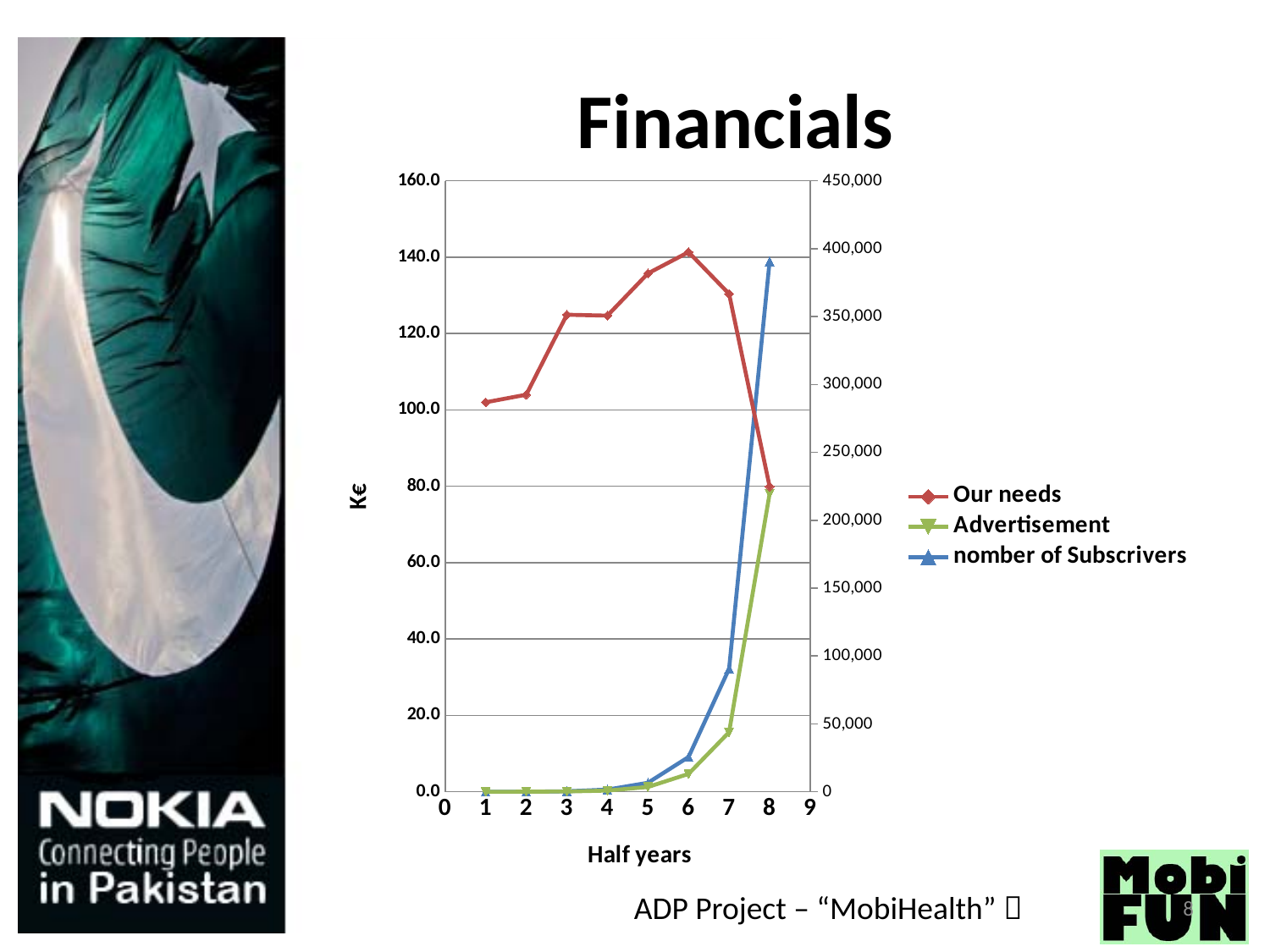
Is the value of Our needs at half year 1 greater or less than 120.0 K€? less How many series does the legend of the Financials chart list? 3 Is the value of Our needs at half year 6 greater or less than 120.0 K€? greater Which is larger for the Our needs series: the value at half year 2 or at half year 6? half year 6 What kind of chart is shown on the Financials slide? line chart Does the Advertisement series rise or fall from half year 1 to half year 8? rise Is the number of Subscrivers at half year 8 greater or less than 350,000? greater At which half year is the Our needs series at its lowest value? 8 What is the label of the left vertical axis of the Financials chart? K€ How many half-year data points are plotted for the Our needs series? 8 At which half year does the Our needs series reach its highest value? 6